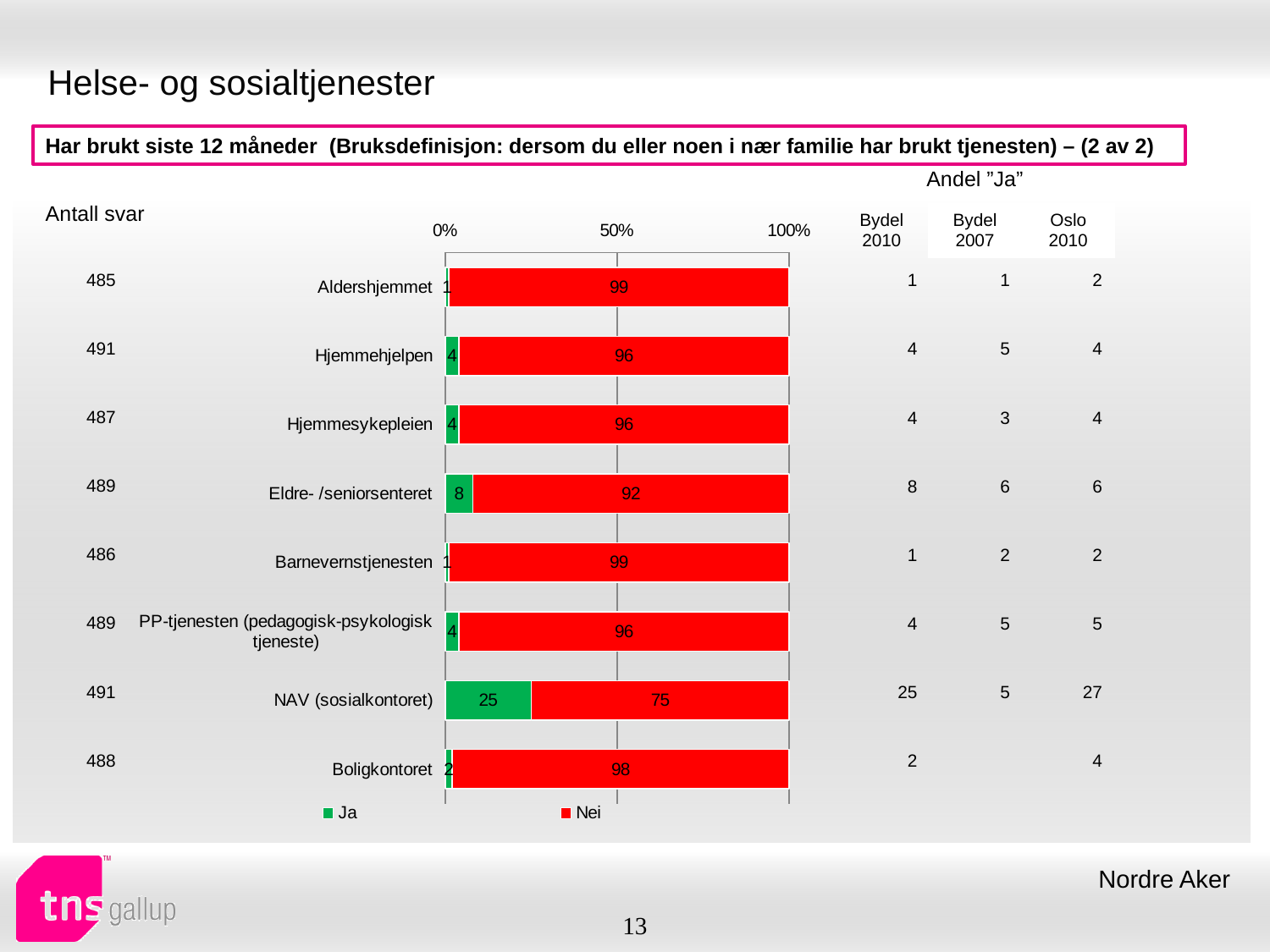
Which is larger, the "Ja" value for Eldre- /seniorsenteret or the "Ja" value for Hjemmehjelpen? Eldre- /seniorsenteret What is the "Nei" value for NAV (sosialkontoret)? 75 Is the "Nei" value for NAV (sosialkontoret) greater or less than 50%? greater What is the total of the stacked bar for Hjemmesykepleien? 100 What kind of chart is shown on the slide? stacked bar chart How many series does the legend list? 2 How many categories are shown in the chart? 8 What is the "Nei" value for Boligkontoret? 98 Which category has the highest "Ja" value? NAV (sosialkontoret) What is the difference between the "Nei" values for Aldershjemmet and NAV (sosialkontoret)? 24 What is the "Ja" value for Eldre- /seniorsenteret? 8 Which category has the lowest "Nei" value? NAV (sosialkontoret)